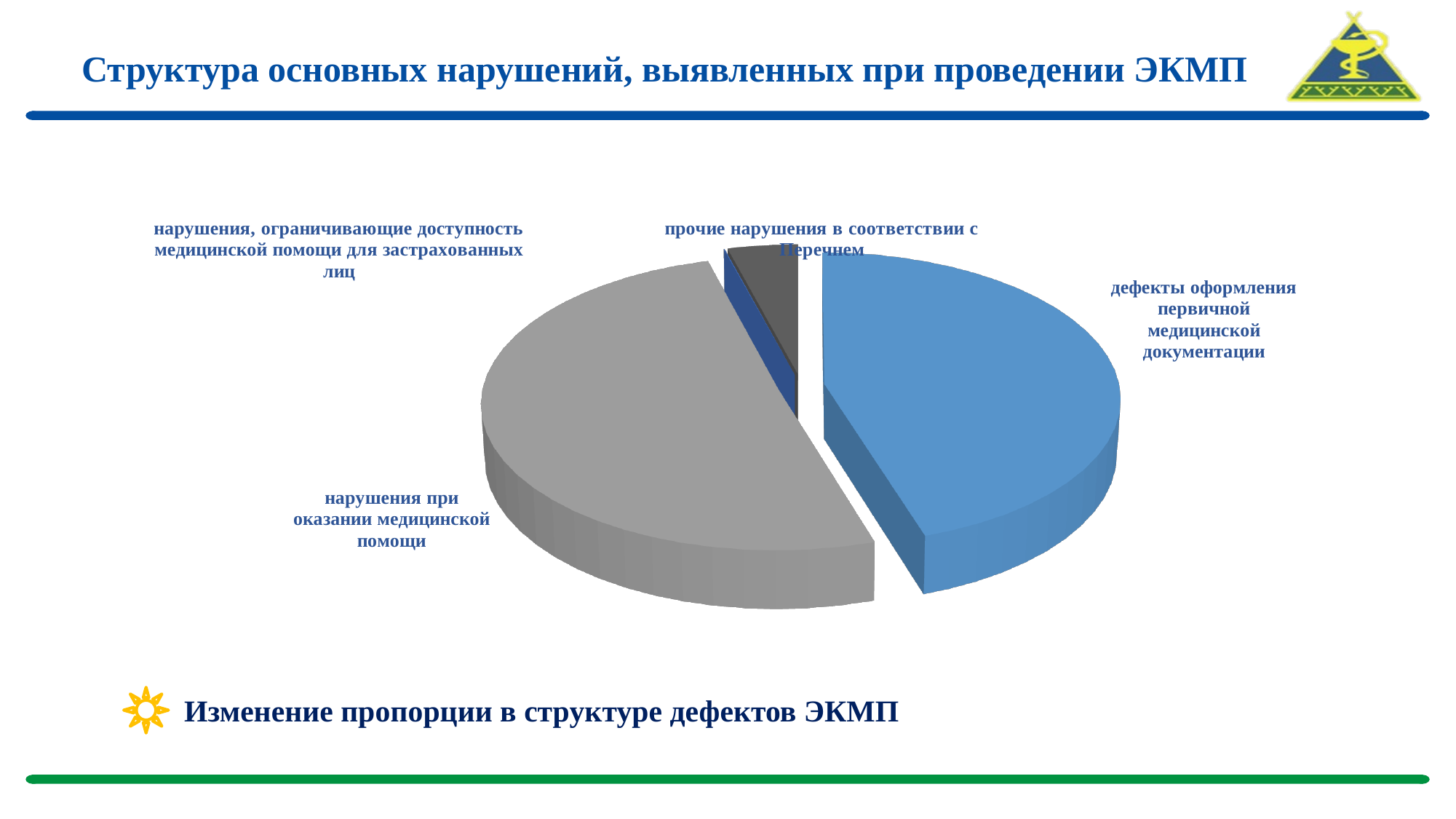
How many slices does the pie chart have? 4 What kind of chart is shown on the slide? pie chart Which slice is larger: "прочие нарушения в соответствии с Перечнем" or "нарушения, ограничивающие доступность медицинской помощи для застрахованных лиц"? прочие нарушения в соответствии с Перечнем What is the title of the slide containing the pie chart? Структура основных нарушений, выявленных при проведении ЭКМП Which category has the smallest slice of the pie chart? нарушения, ограничивающие доступность медицинской помощи для застрахованных лиц Which category has the largest slice of the pie chart? нарушения при оказании медицинской помощи Which slice is larger: "нарушения при оказании медицинской помощи" or "нарушения, ограничивающие доступность медицинской помощи для застрахованных лиц"? нарушения при оказании медицинской помощи What colour is the slice for "дефекты оформления первичной медицинской документации"? blue Which slice is larger: "дефекты оформления первичной медицинской документации" or "прочие нарушения в соответствии с Перечнем"? дефекты оформления первичной медицинской документации